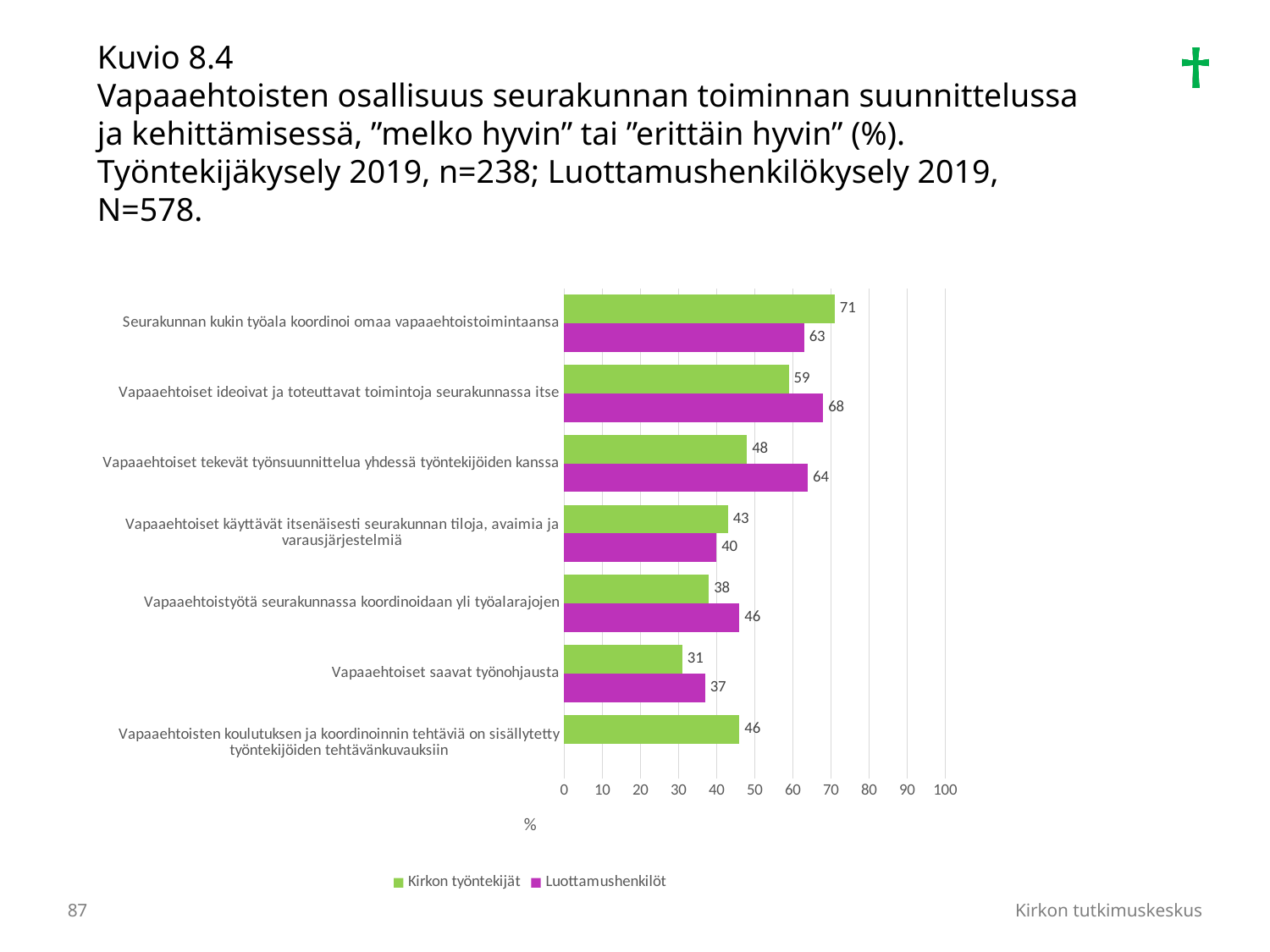
What is the value for Luottamushenkilöt for "Vapaaehtoiset ideoivat ja toteuttavat toimintoja seurakunnassa itse"? 68 What kind of chart is shown on the slide? bar chart Which category has the highest value for Kirkon työntekijät? Seurakunnan kukin työala koordinoi omaa vapaaehtoistoimintaansa Is the Kirkon työntekijät value for "Vapaaehtoisten koulutuksen ja koordinoinnin tehtäviä on sisällytetty työntekijöiden tehtävänkuvauksiin" greater or less than 40? greater What is the value for Luottamushenkilöt for "Vapaaehtoiset saavat työnohjausta"? 37 How many categories are shown on the chart? 7 For "Vapaaehtoistyötä seurakunnassa koordinoidaan yli työalarajojen", which series has the larger value, Kirkon työntekijät or Luottamushenkilöt? Luottamushenkilöt Which category has the lowest value for Kirkon työntekijät? Vapaaehtoiset saavat työnohjausta How many series does the legend list? 2 Which colour represents Luottamushenkilöt in the chart? purple What is the value for Kirkon työntekijät for "Seurakunnan kukin työala koordinoi omaa vapaaehtoistoimintaansa"? 71 What is the difference between the Luottamushenkilöt and Kirkon työntekijät values for "Vapaaehtoiset tekevät työnsuunnittelua yhdessä työntekijöiden kanssa"? 16